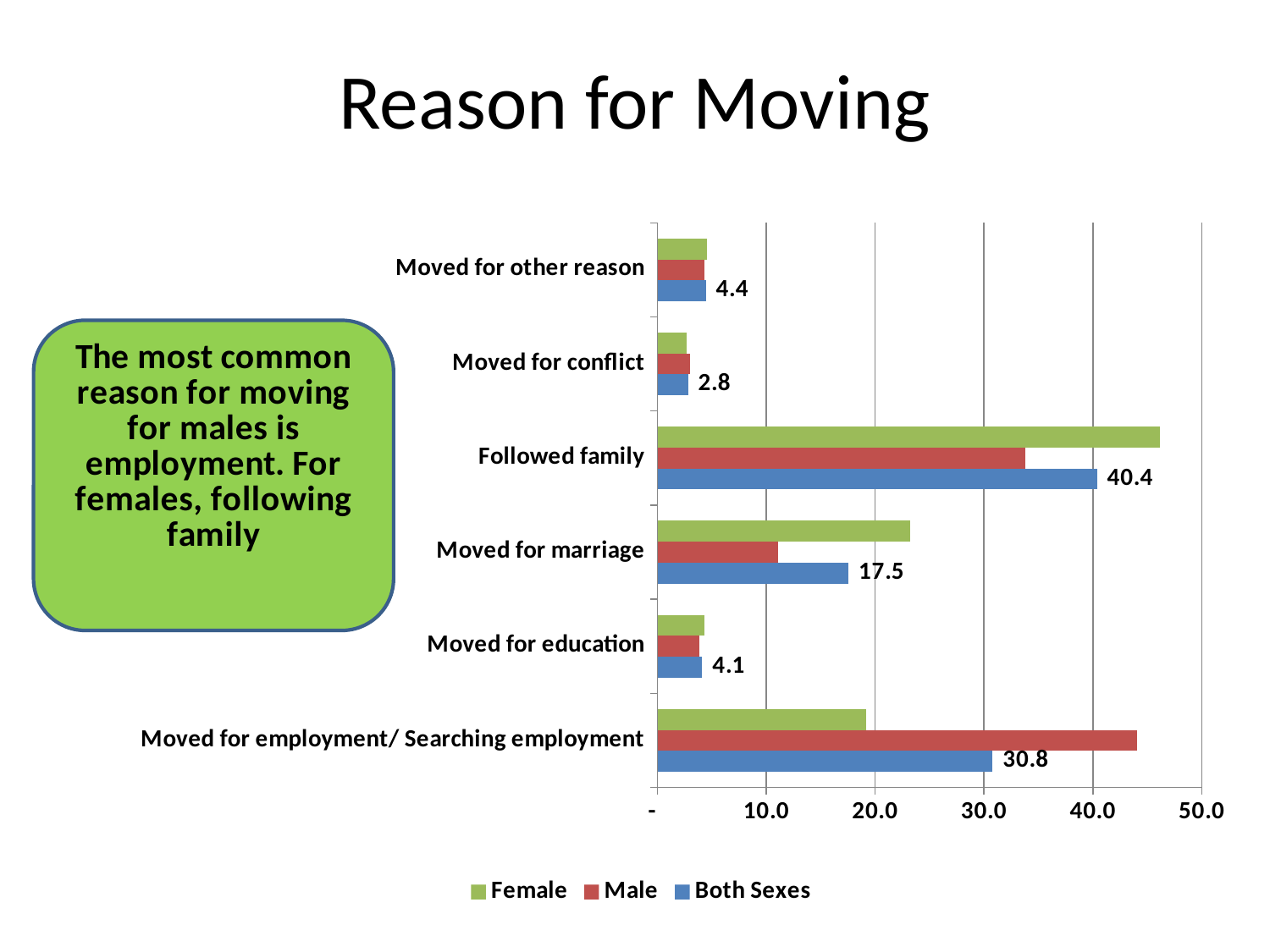
What is the Both Sexes value for Moved for employment/ Searching employment? 30.8 Is the Male value for Moved for employment/ Searching employment greater or less than 40.0? greater What type of chart is shown on the slide? bar chart How many reason categories are plotted on the chart? 6 What is the Both Sexes value for Moved for conflict? 2.8 What is the difference between the Both Sexes values for Followed family and Moved for employment/ Searching employment? 9.6 What is the Both Sexes value for Followed family? 40.4 How many series does the legend list? 3 What is the Both Sexes value for Moved for marriage? 17.5 Which category has the lowest Both Sexes value? Moved for conflict Which is larger for Followed family, the Female value or the Male value? Female Which category has the highest Both Sexes value? Followed family